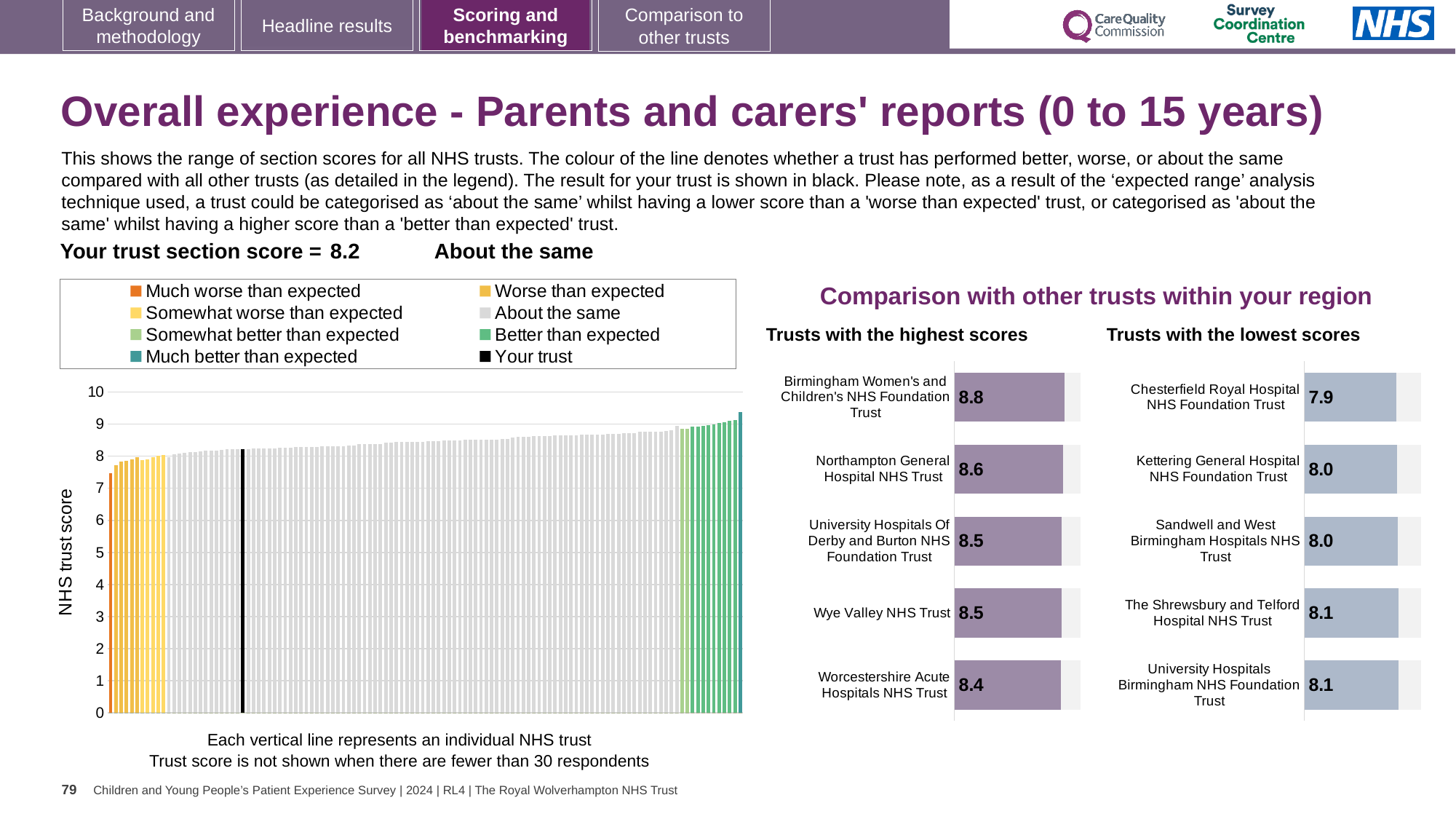
In the NHS trust score chart on the left, what is the section score for your trust? 8.2 In the 'Trusts with the highest scores' chart, what is the score for Birmingham Women's and Children's NHS Foundation Trust? 8.8 In the 'Trusts with the lowest scores' chart, what is the score for The Shrewsbury and Telford Hospital NHS Trust? 8.1 In the 'Trusts with the lowest scores' chart, what is the score for Chesterfield Royal Hospital NHS Foundation Trust? 7.9 In the 'Trusts with the highest scores' chart, which trust has the highest score? Birmingham Women's and Children's NHS Foundation Trust What kind of chart is the NHS trust score chart on the left? Bar chart In the 'Trusts with the lowest scores' chart, which has the larger score: Chesterfield Royal Hospital NHS Foundation Trust or Kettering General Hospital NHS Foundation Trust? Kettering General Hospital NHS Foundation Trust How many entries does the legend of the NHS trust score chart on the left list? 8 In the 'Trusts with the highest scores' chart, what is the difference between the scores of Birmingham Women's and Children's NHS Foundation Trust and Worcestershire Acute Hospitals NHS Trust? 0.4 In the 'Trusts with the highest scores' chart, what is the score for Worcestershire Acute Hospitals NHS Trust? 8.4 In the 'Trusts with the lowest scores' chart, which trust has the lowest score? Chesterfield Royal Hospital NHS Foundation Trust How many trusts are shown in the 'Trusts with the highest scores' chart? 5